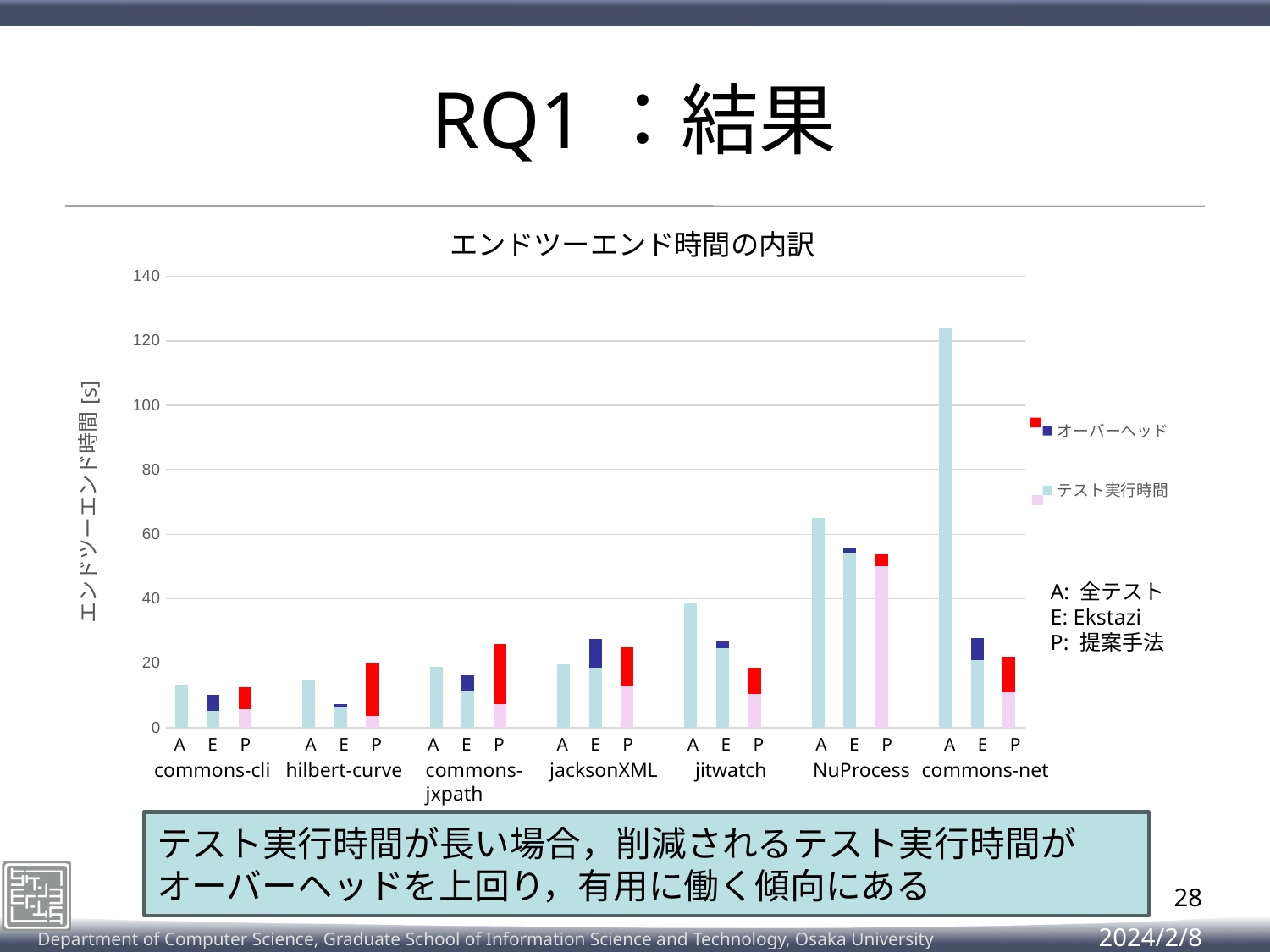
Which is larger, the A bar for NuProcess or the A bar for commons-cli? NuProcess Is the value of the A bar for NuProcess greater or less than 60? greater How many series does the chart legend list? 2 What is the title of the chart? エンドツーエンド時間の内訳 What kind of chart is shown on the slide? bar chart How many projects are shown along the x axis of the chart? 7 What is the label of the y axis of the chart? エンドツーエンド時間 [s] Which project has the tallest bar in the chart? commons-net Is the value of the E bar for hilbert-curve greater or less than 20? less Is the total of the P bar for NuProcess greater or less than 40? greater